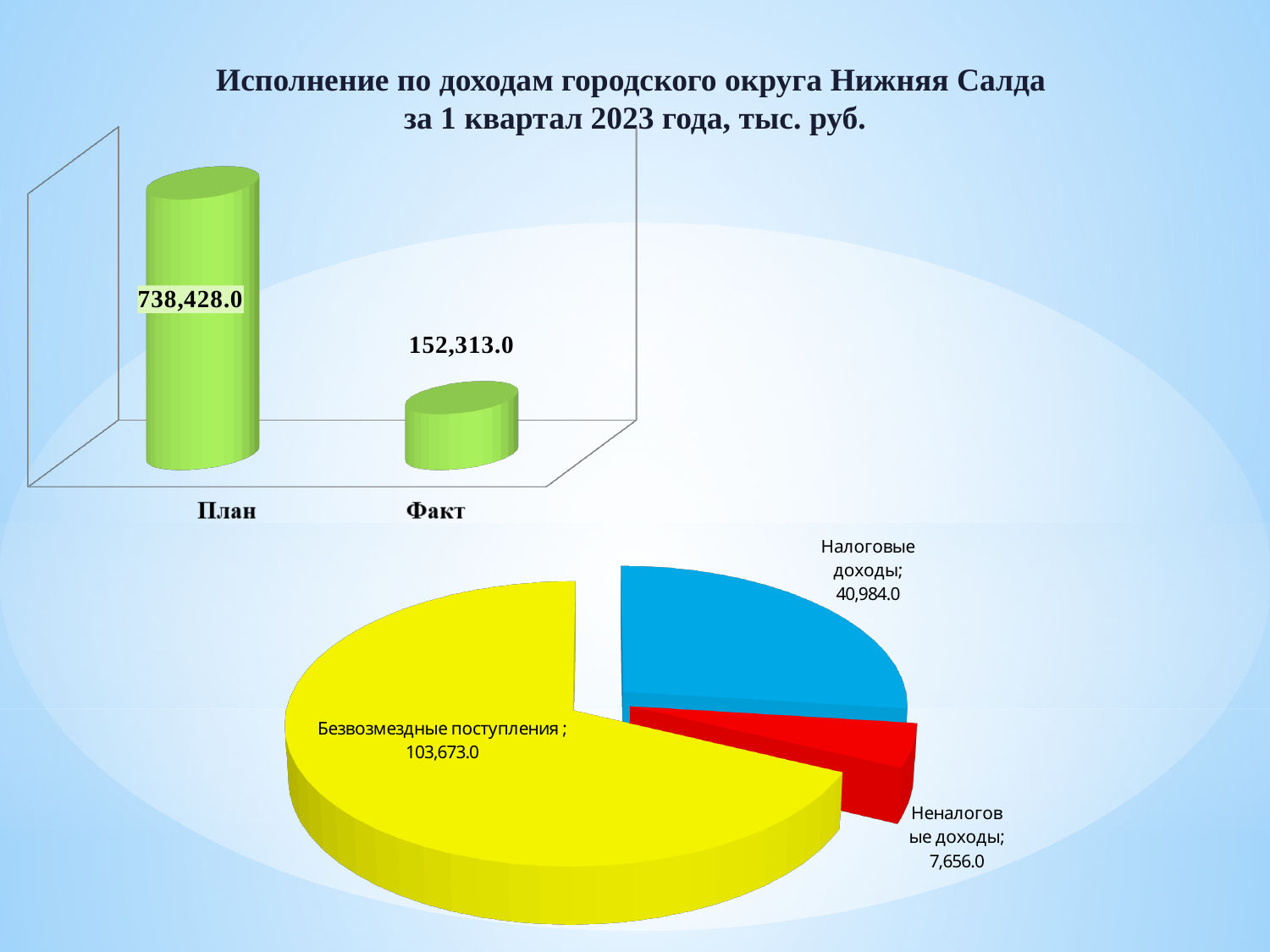
On the bar chart at the top of the slide, what is the value for План? 738,428.0 On the pie chart at the bottom of the slide, which slice is the smallest? Неналоговые доходы On the bar chart at the top of the slide, what is the difference between the План and Факт values? 586,115.0 On the pie chart at the bottom of the slide, what colour is the Неналоговые доходы slice? Red On the bar chart at the top of the slide, how many categories are shown? 2 On the pie chart at the bottom of the slide, what is the value for Неналоговые доходы? 7,656.0 On the bar chart at the top of the slide, what is the value for Факт? 152,313.0 On the pie chart at the bottom of the slide, which slice is the largest? Безвозмездные поступления What kind of chart is the top chart on the slide? Bar chart On the pie chart at the bottom of the slide, what is the value for Налоговые доходы? 40,984.0 On the bar chart at the top of the slide, which category has the higher value, План or Факт? План On the pie chart at the bottom of the slide, what is the difference between Безвозмездные поступления and Налоговые доходы? 62,689.0